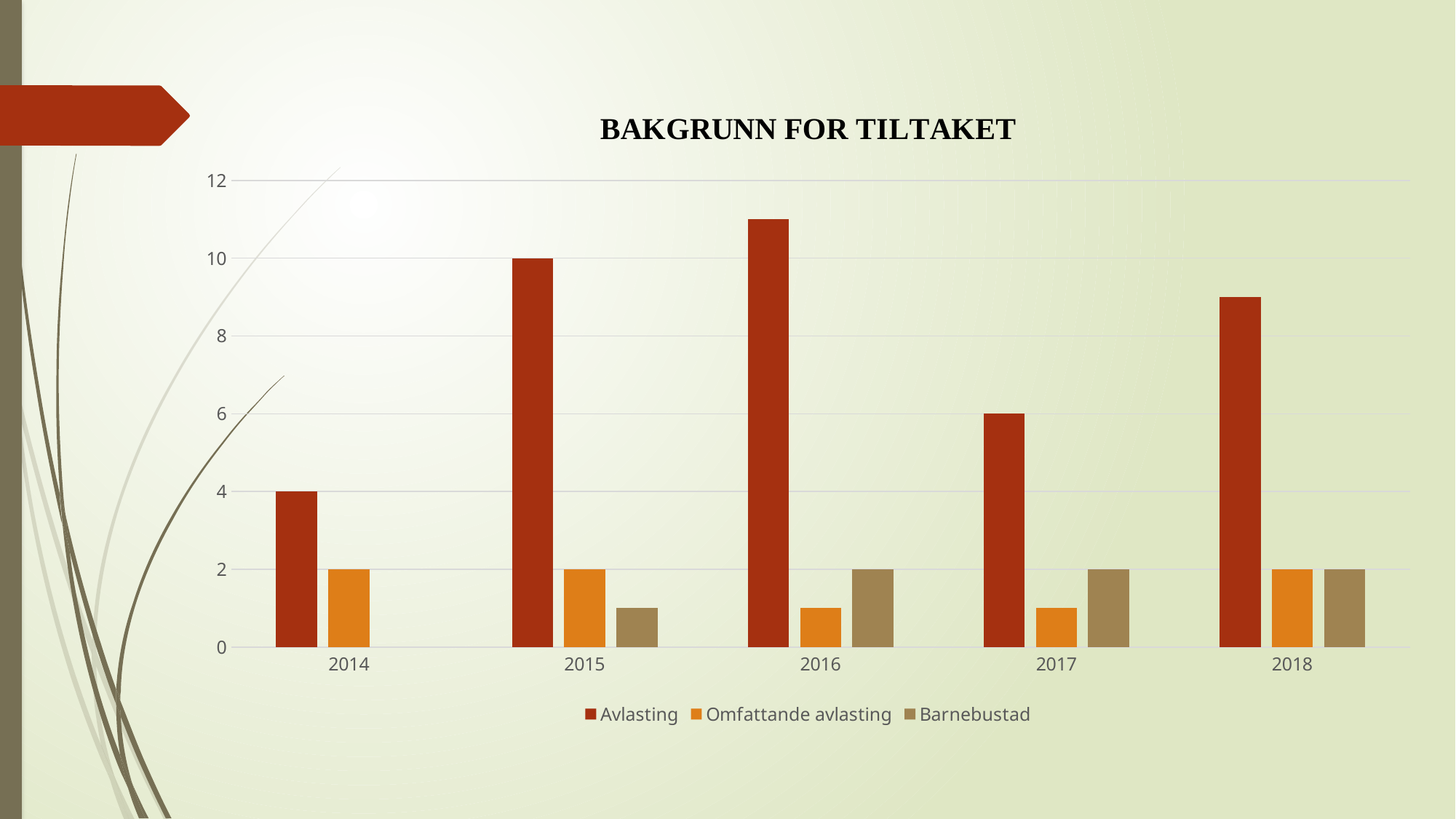
What is the value for Avlasting in 2014? 4 What type of chart is shown on the slide? Bar chart In which year is the Avlasting value highest? 2016 How many series does the legend list? 3 Which is larger, the Avlasting value for 2017 or for 2018? 2018 What is the difference between the Avlasting values for 2015 and 2017? 4 How many years are shown on the x axis? 5 What is the title of the chart? BAKGRUNN FOR TILTAKET Is the value for Avlasting in 2016 greater or less than 10? greater What is the value for Barnebustad in 2017? 2 In which year is the Avlasting value lowest? 2014 What is the value for Avlasting in 2015? 10